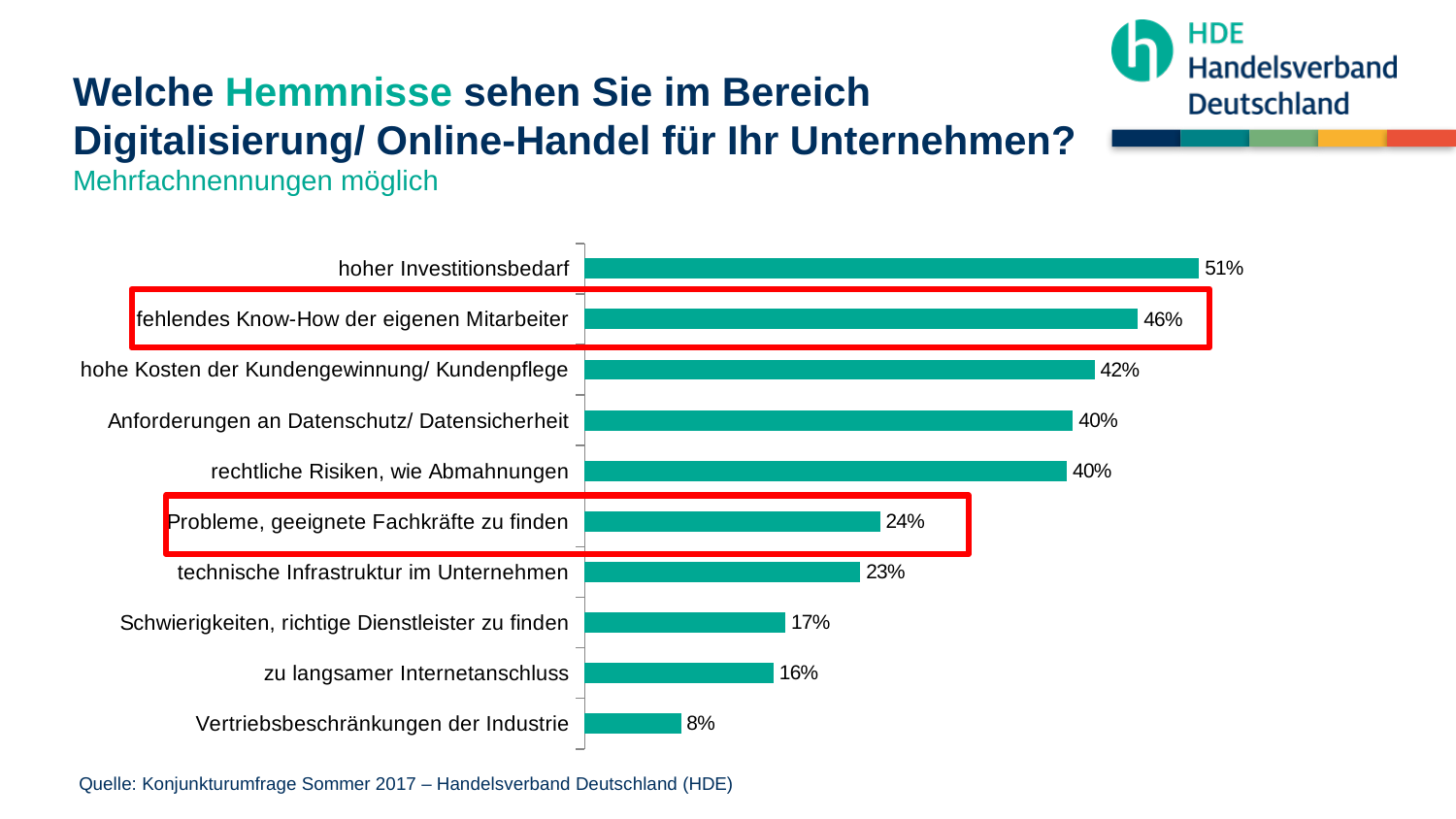
What is the value for 'zu langsamer Internetanschluss'? 16% Which two categories are highlighted with red boxes? fehlendes Know-How der eigenen Mitarbeiter; Probleme, geeignete Fachkräfte zu finden What is the difference between 'hoher Investitionsbedarf' and 'fehlendes Know-How der eigenen Mitarbeiter'? 5% What is the difference between 'hohe Kosten der Kundengewinnung/ Kundenpflege' and 'Vertriebsbeschränkungen der Industrie'? 34% Which is larger: 'technische Infrastruktur im Unternehmen' or 'Schwierigkeiten, richtige Dienstleister zu finden'? technische Infrastruktur im Unternehmen What is the value for 'hoher Investitionsbedarf'? 51% What is the source given below the chart? Konjunkturumfrage Sommer 2017 – Handelsverband Deutschland (HDE) How many categories are shown in the chart? 10 What is the value for 'Probleme, geeignete Fachkräfte zu finden'? 24% What kind of chart is shown on the slide? bar chart Which category has the highest value? hoher Investitionsbedarf Which category has the lowest value? Vertriebsbeschränkungen der Industrie